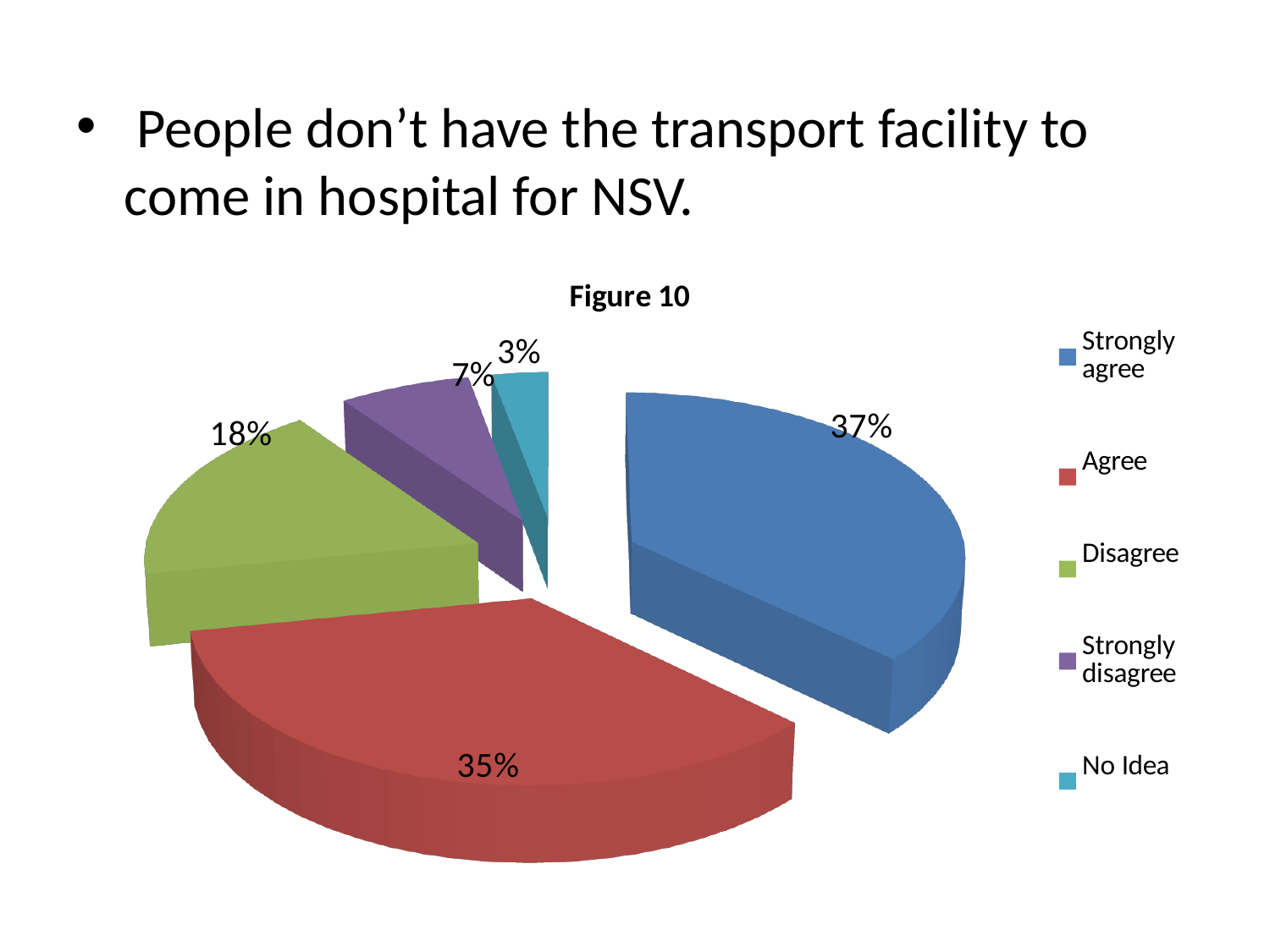
What share of the pie is labelled No Idea? 3% What is the title of the chart? Figure 10 What is the difference in percentage points between the Disagree and Strongly disagree slices? 11 Which is larger, the Agree slice or the Disagree slice? Agree Which category has the largest share of the pie? Strongly agree What kind of chart is shown on the slide? Pie chart Which category has the smallest share of the pie? No Idea What share of the pie is labelled Strongly agree? 37% What share of the pie is labelled Agree? 35% What share of the pie is labelled Strongly disagree? 7% How many slices does the pie chart have? 5 What share of the pie is labelled Disagree? 18%